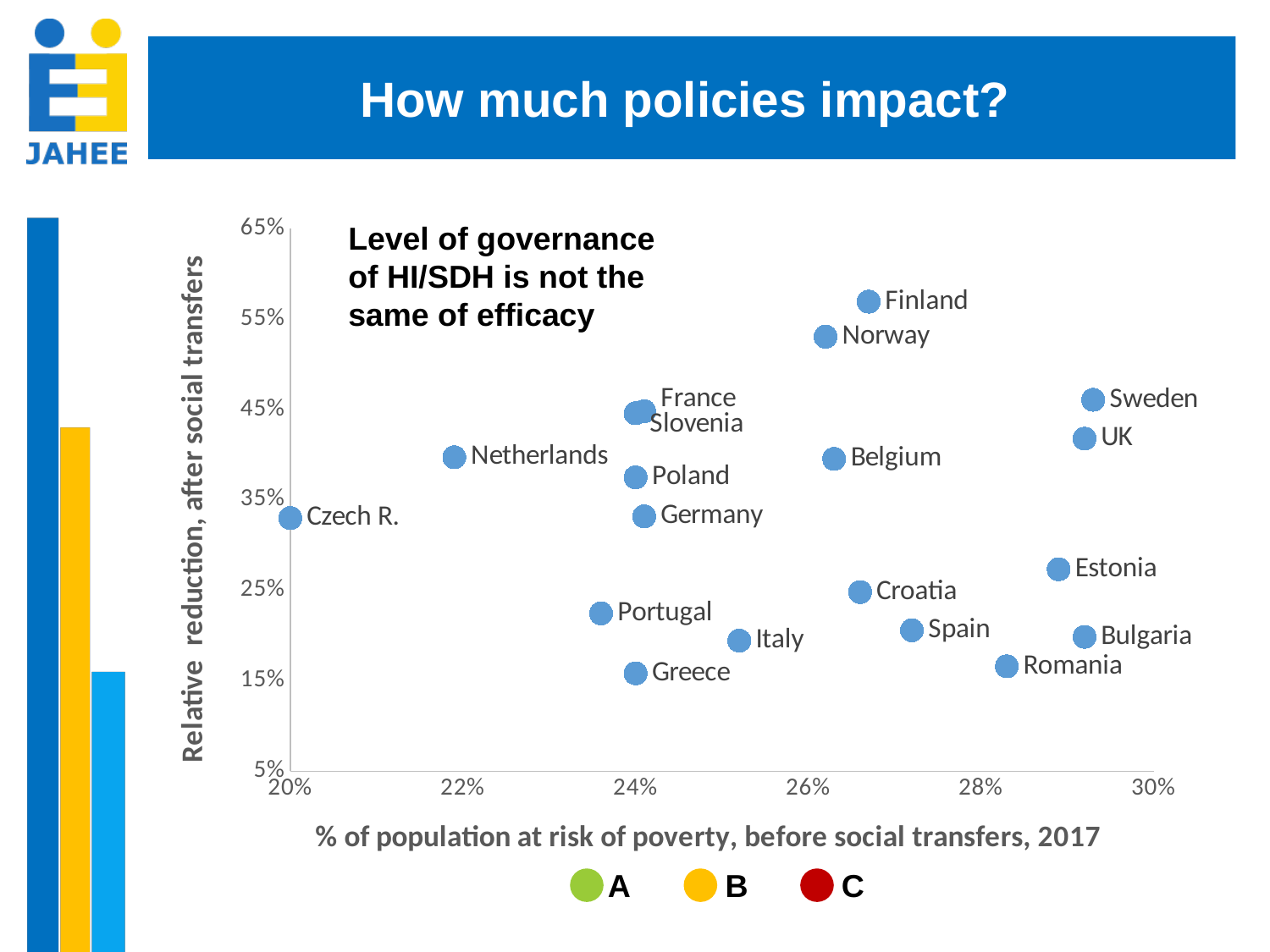
Is the relative reduction for Norway greater or less than 55%? less Is the relative reduction for Greece greater or less than 25%? less Which has a higher relative reduction after social transfers, Netherlands or Portugal? Netherlands Which has a higher relative reduction after social transfers, Sweden or UK? Sweden Which country has the highest relative reduction after social transfers? Finland Is the relative reduction for Finland greater or less than 55%? greater What kind of chart is shown on the slide? scatter chart What is the title of the x axis? % of population at risk of poverty, before social transfers, 2017 How many countries are plotted on the chart? 19 Which country has the lowest % of population at risk of poverty before social transfers? Czech R. How many entries does the legend list? 3